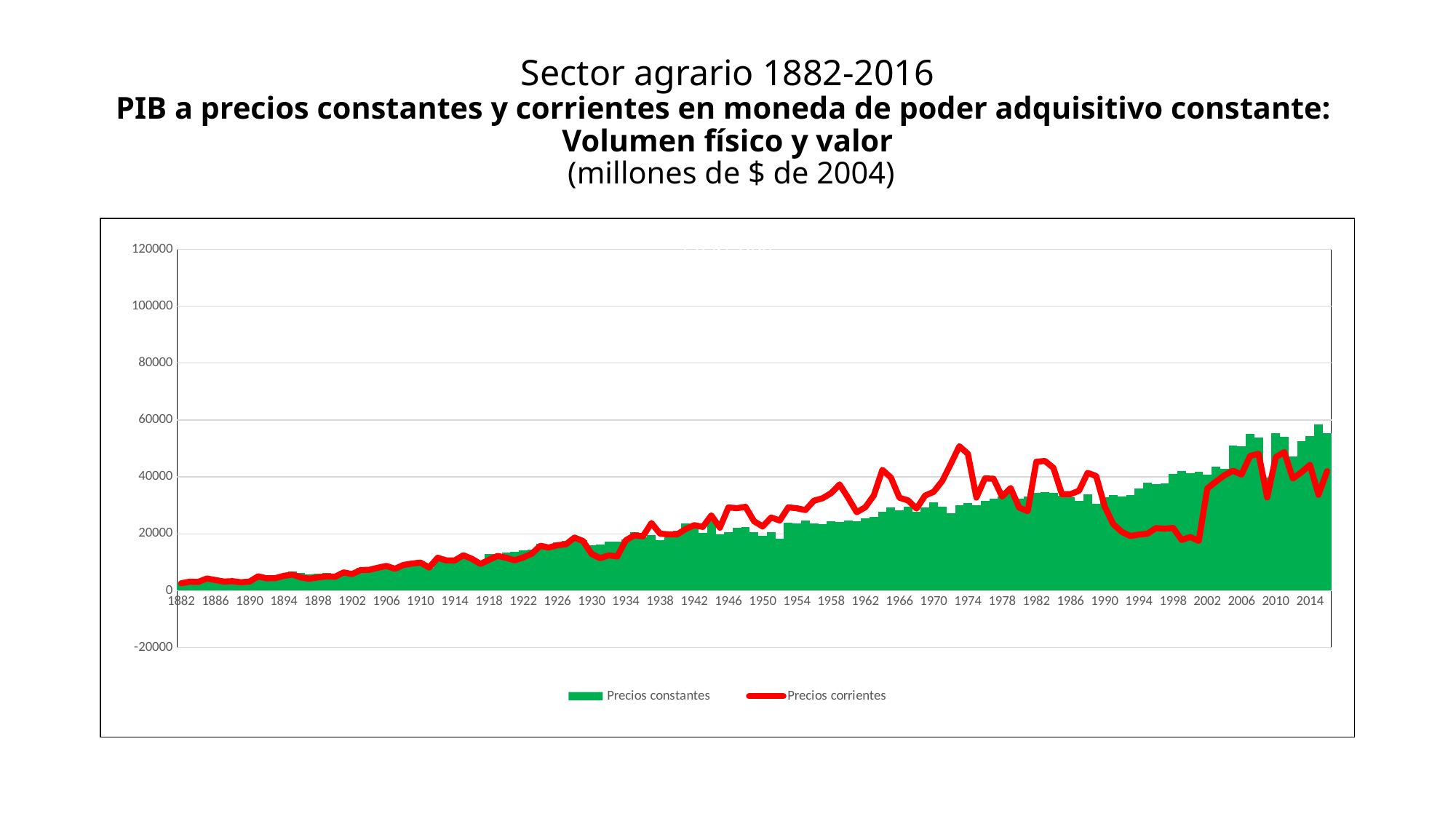
What colour are the bars for Precios constantes? Green In 1974, which is larger, Precios constantes or Precios corrientes? Precios corrientes How many series does the chart legend list? 2 What kind of chart is shown on the slide? A combined bar chart and line chart Is the value for Precios constantes in 2014 greater or less than 40000? greater Is the value for Precios constantes in 1882 greater or less than 20000? less Is the value for Precios corrientes in 1962 greater or less than 20000? greater Overall, do the Precios constantes values rise or fall from 1882 to 2016? Rise Which series is drawn as a red line? Precios corrientes What is the highest value shown on the vertical axis? 120000 In 1994, which is larger, Precios constantes or Precios corrientes? Precios constantes